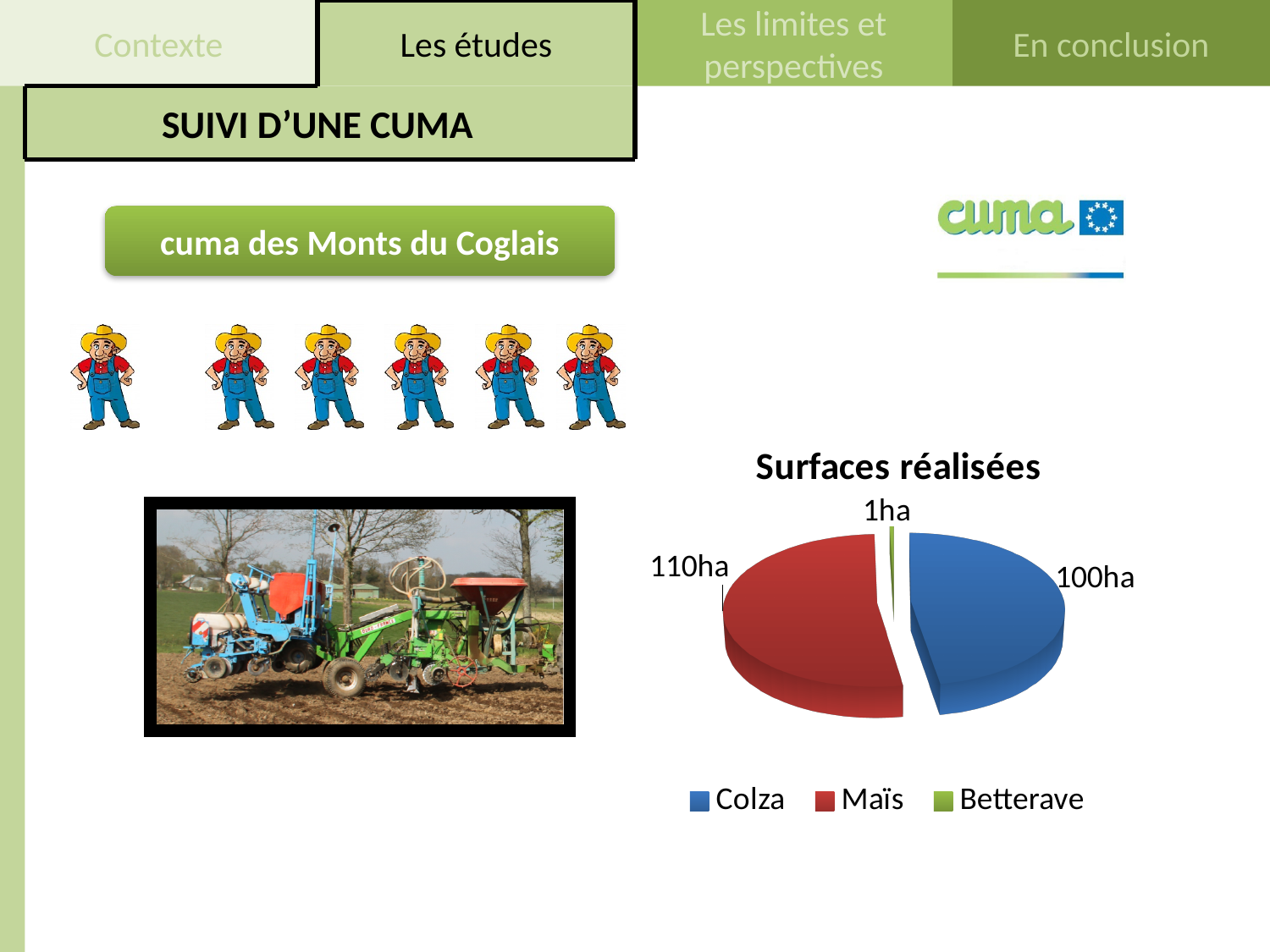
What is the value for Maïs in the pie chart? 110ha Which crop has the smallest surface in the pie chart? Betterave What type of chart is shown on the slide? Pie chart How many slices does the pie chart have? 3 Which crop has the largest surface in the pie chart? Maïs What is the title of the chart? Surfaces réalisées Which is larger, the surface for Colza or the surface for Maïs? Maïs What is the difference between the surfaces for Maïs and Colza? 10ha What is the total surface across all three slices of the pie chart? 211ha Which colour represents Colza in the pie chart? Blue What is the value for Colza in the pie chart? 100ha What is the value for Betterave in the pie chart? 1ha